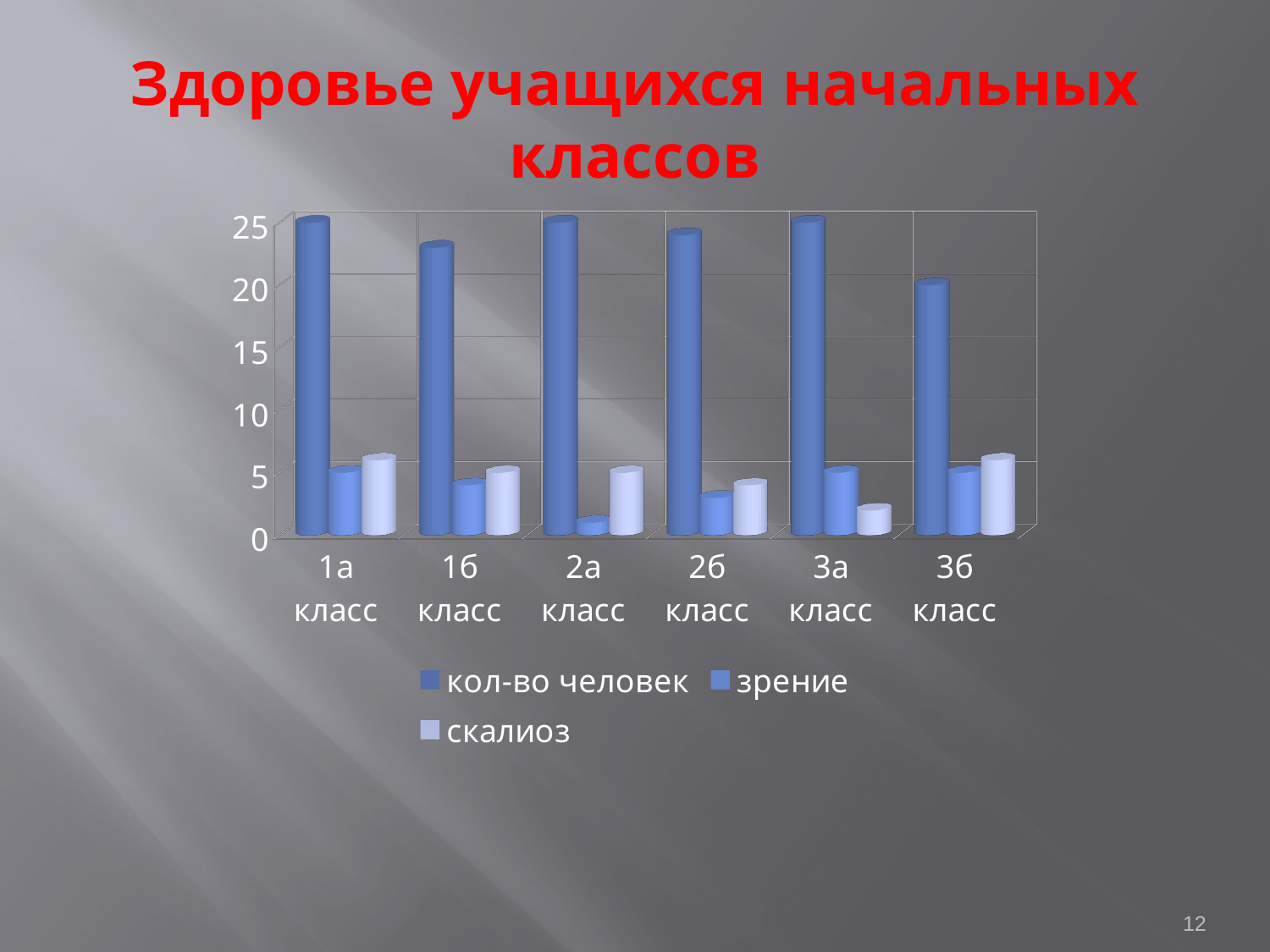
Which series are listed in the legend? кол-во человек, зрение, скалиоз How many classes (categories) are shown on the x axis? 6 How many series does the legend list? 3 Which class has the larger value for кол-во человек: 1б класс or 3б класс? 1б класс What is the title of the chart slide? Здоровье учащихся начальных классов What kind of chart is shown on the slide? bar chart Which class has the lowest value for зрение? 2а класс Is the value for зрение in 2а класс greater or less than 5? less Which class has the lowest value for скалиоз? 3а класс Which class has the lowest value for кол-во человек? 3б класс In 2а класс, which is larger: зрение or скалиоз? скалиоз Is the value for кол-во человек in 3б класс greater or less than 25? less